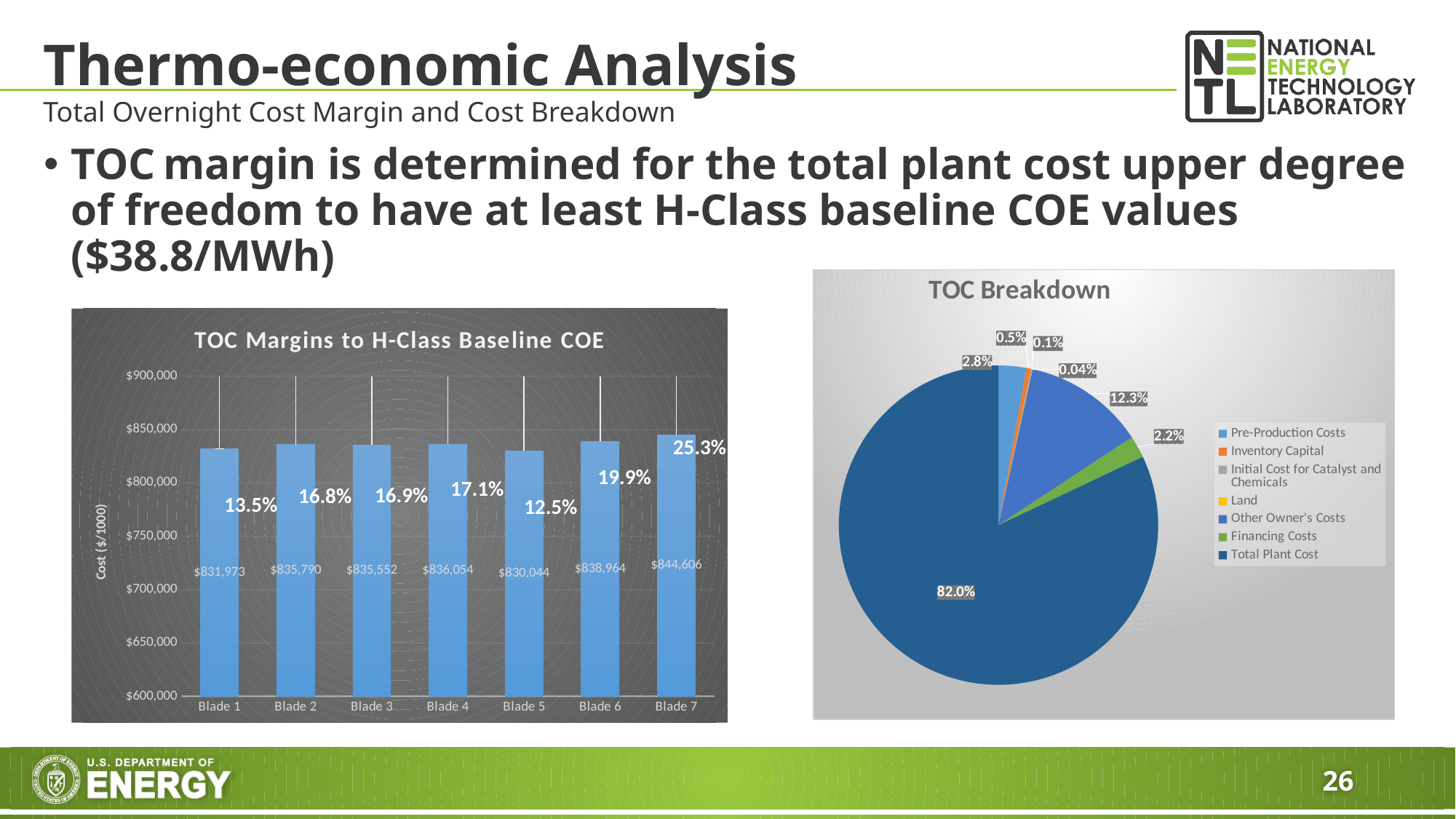
How many blades are shown in the TOC Margins to H-Class Baseline COE chart? 7 In the TOC Breakdown chart, what percentage is shown for Other Owner's Costs? 12.3% In the TOC Margins to H-Class Baseline COE chart, which blade has the highest cost? Blade 7 In the TOC Margins to H-Class Baseline COE chart, which has the larger TOC margin percentage, Blade 4 or Blade 6? Blade 6 In the TOC Margins to H-Class Baseline COE chart, what is the cost value labelled for Blade 7? $844,606 In the TOC Margins to H-Class Baseline COE chart, which blade has the lowest cost? Blade 5 In the TOC Margins to H-Class Baseline COE chart, what is the difference between the cost of Blade 7 and the cost of Blade 5? $14,562 What kind of chart is the TOC Margins to H-Class Baseline COE chart? bar chart In the TOC Margins to H-Class Baseline COE chart, what TOC margin percentage is shown for Blade 1? 13.5% In the TOC Breakdown chart, what share does Total Plant Cost represent? 82.0% In the TOC Margins to H-Class Baseline COE chart, is the cost for Blade 1 greater or less than $800,000? greater How many categories does the legend of the TOC Breakdown chart list? 7